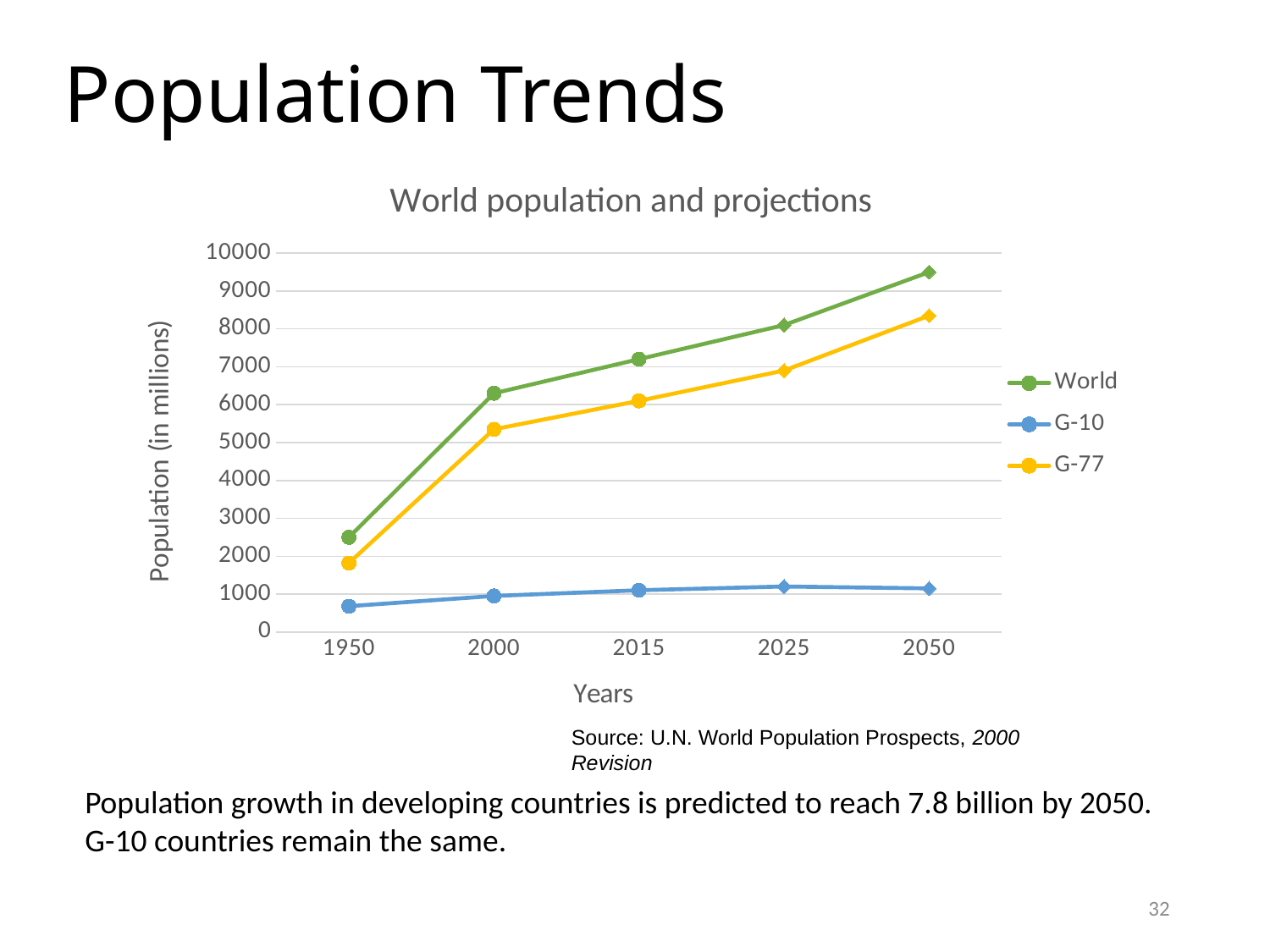
What kind of chart is shown on the slide? line chart Does the World series rise or fall from 1950 to 2050? rise Which is larger, the G-77 value in 2050 or the World value in 2000? G-77 in 2050 What is the title of the chart? World population and projections How many series does the legend list? 3 Which series has the lowest value in 1950? G-10 Is the value for G-77 in 2000 greater or less than 6000? less Is the value for World in 2050 greater or less than 9000? greater Which series has the highest value in 2050? World Is the value for World in 2015 greater or less than 7000? greater How many years are plotted along the x axis? 5